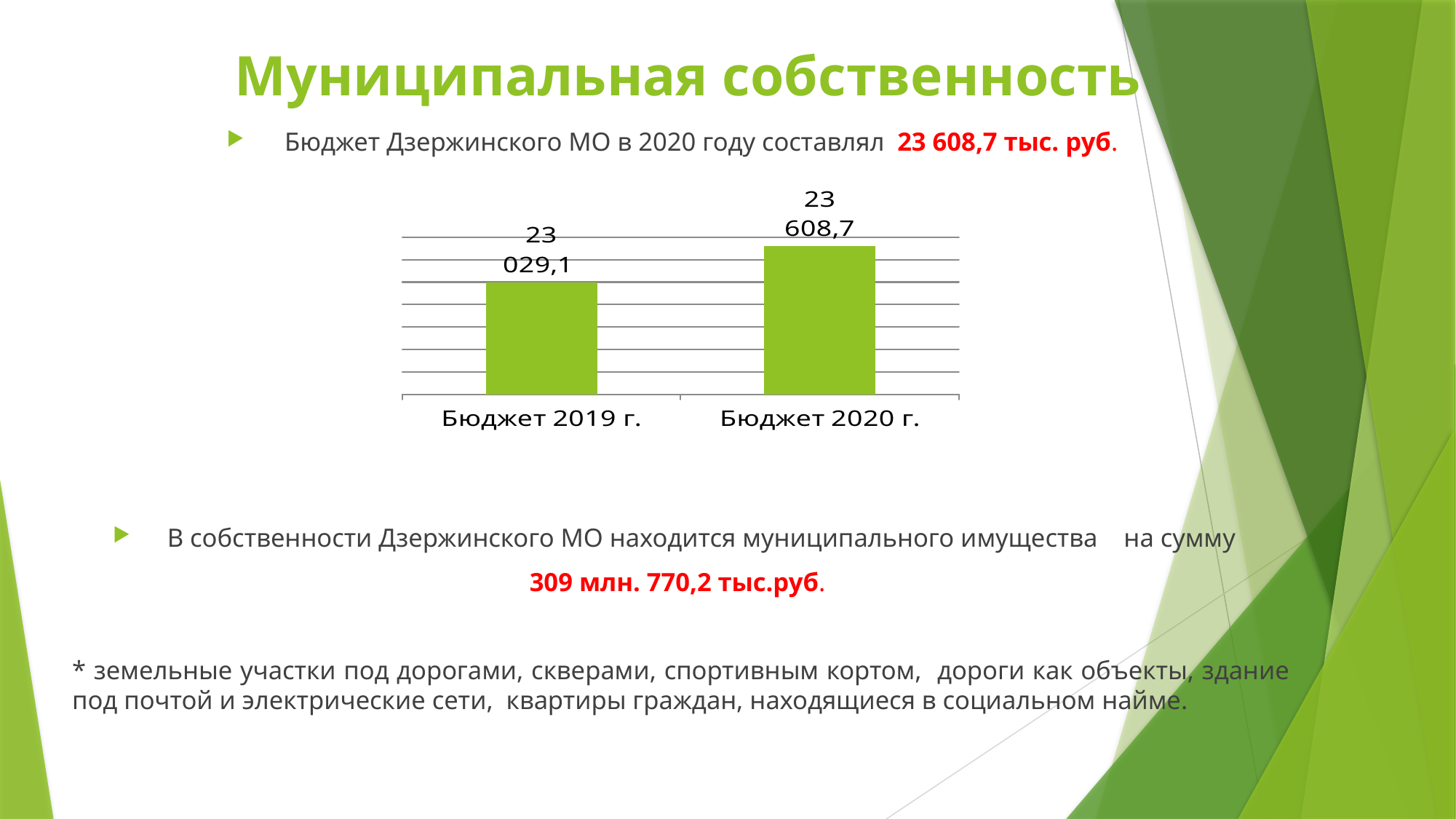
Do the values rise or fall from Бюджет 2019 г. to Бюджет 2020 г.? Rise What is the label of the first category on the x axis? Бюджет 2019 г. What is the value shown for Бюджет 2020 г.? 23 608,7 What kind of chart is shown on the slide? Bar chart Which category has the highest value in the chart? Бюджет 2020 г. Which category has the lowest value in the chart? Бюджет 2019 г. How many bars are plotted in the chart? 2 What colour are the bars in the chart? Green Which is larger, the value for Бюджет 2019 г. or the value for Бюджет 2020 г.? Бюджет 2020 г. What is the difference between the values for Бюджет 2020 г. and Бюджет 2019 г.? 579,6 What is the value shown for Бюджет 2019 г.? 23 029,1